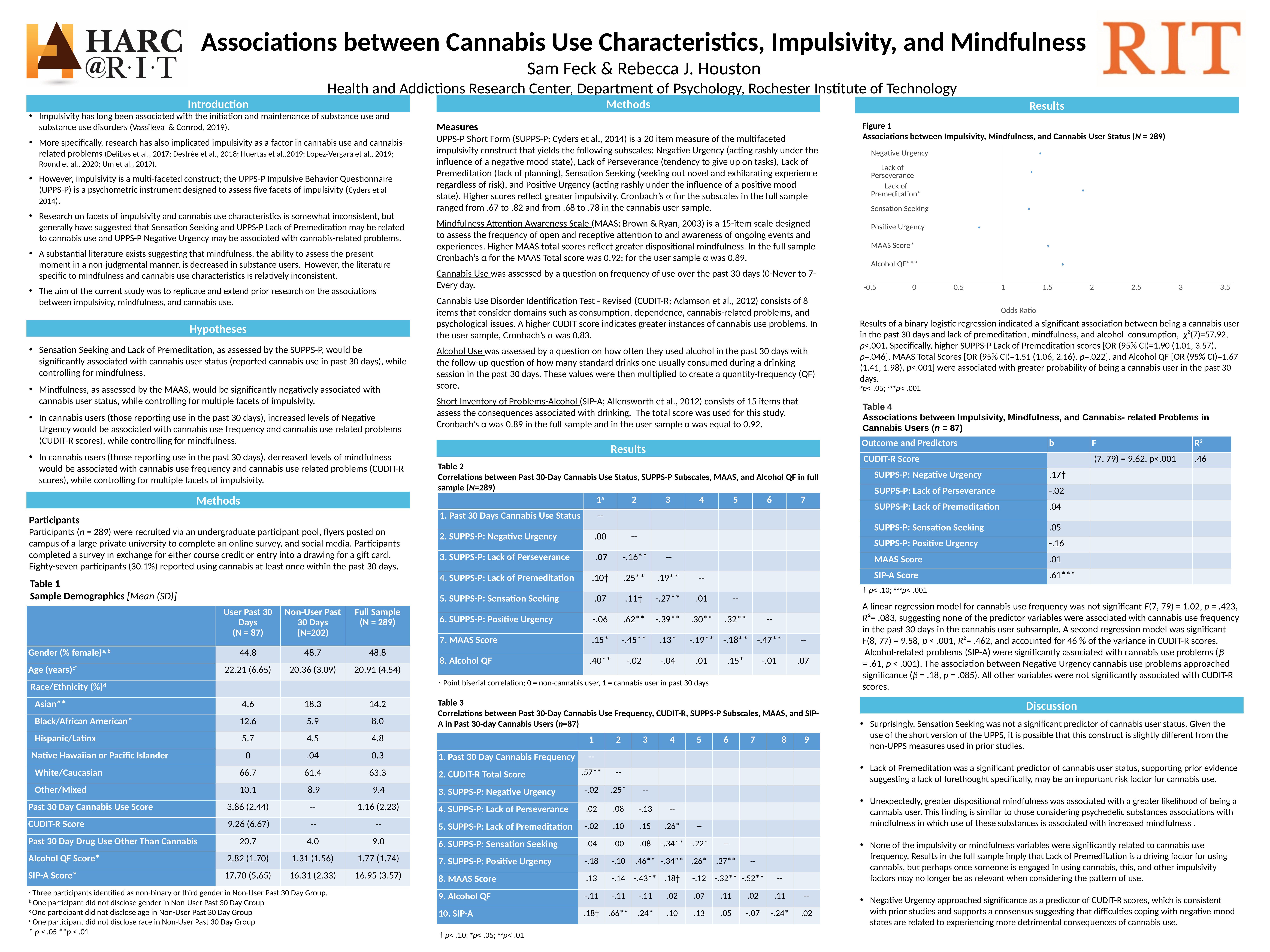
In Figure 1, which category has the highest odds ratio? Lack of Premeditation* What kind of chart is Figure 1? scatter plot In Figure 1, is the odds ratio for Alcohol QF*** greater or less than 1.5? greater In Figure 1, which has the larger odds ratio, Positive Urgency or MAAS Score*? MAAS Score* In Figure 1, is the odds ratio for Lack of Premeditation* greater or less than 1.5? greater In Figure 1, how many categories are plotted on the vertical axis? 7 In Figure 1, is the odds ratio for Lack of Perseverance greater or less than 1? greater What is the label of the horizontal axis in Figure 1? Odds Ratio In Figure 1, which has the larger odds ratio, Alcohol QF*** or Sensation Seeking? Alcohol QF*** In Figure 1, which category has the lowest odds ratio? Positive Urgency